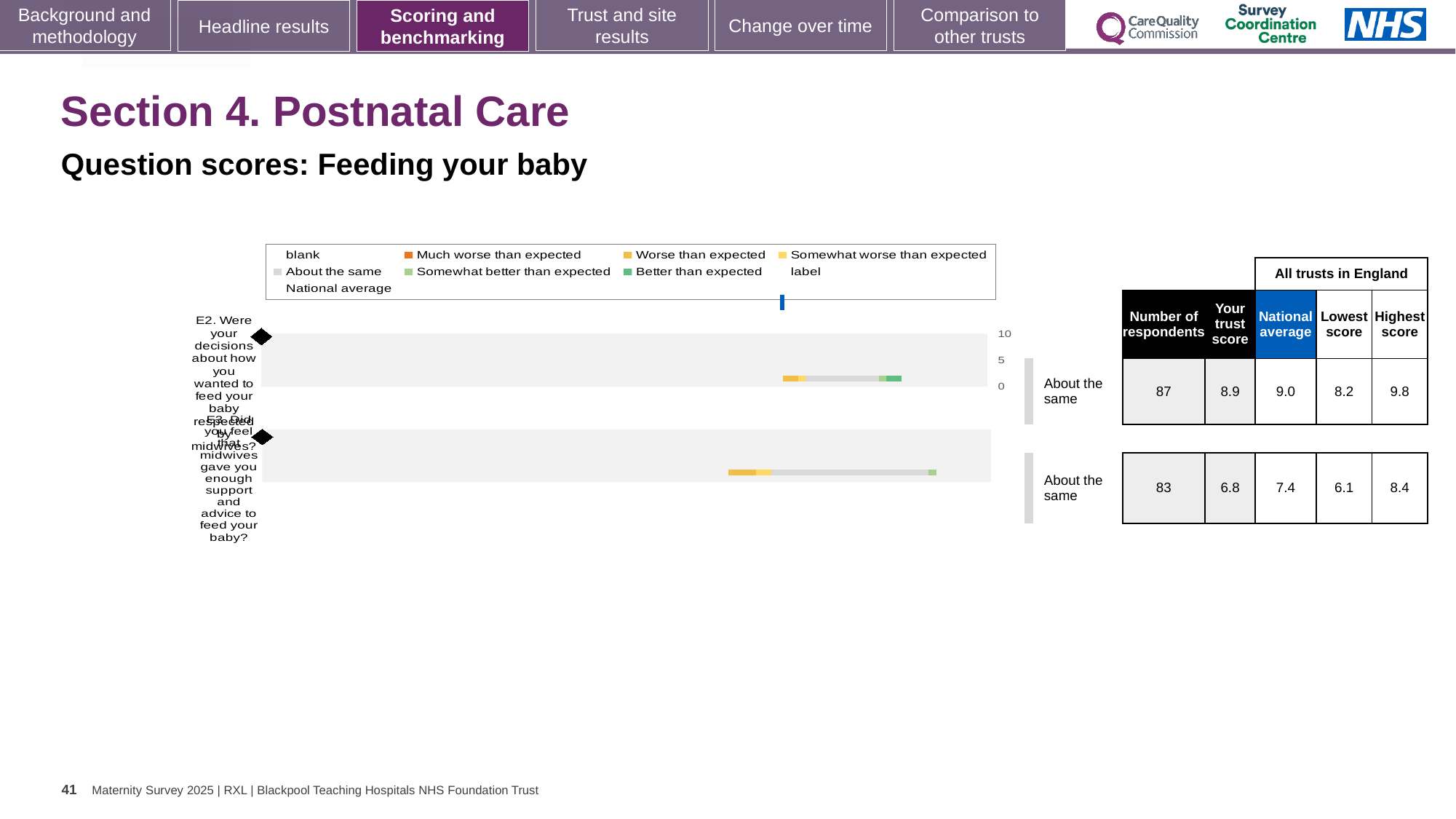
What benchmark category is given for question E2? About the same How many questions (categories) are plotted in the chart? 2 What is the difference between the highest and lowest scores for question E2? 1.6 What is the trust score for question E3 (midwives gave you enough support and advice to feed your baby)? 6.8 Which question has the higher trust score, E2 or E3? E2 How many respondents answered question E3? 83 What is the trust score for question E2 (decisions about how you wanted to feed your baby respected by midwives)? 8.9 What is the difference between the trust score and the national average for question E3? 0.6 What is the national average for question E2? 9.0 What is the highest score among all trusts in England for question E3? 8.4 What is the subtitle of the chart on the slide? Question scores: Feeding your baby What kind of chart is shown on the slide? bar chart